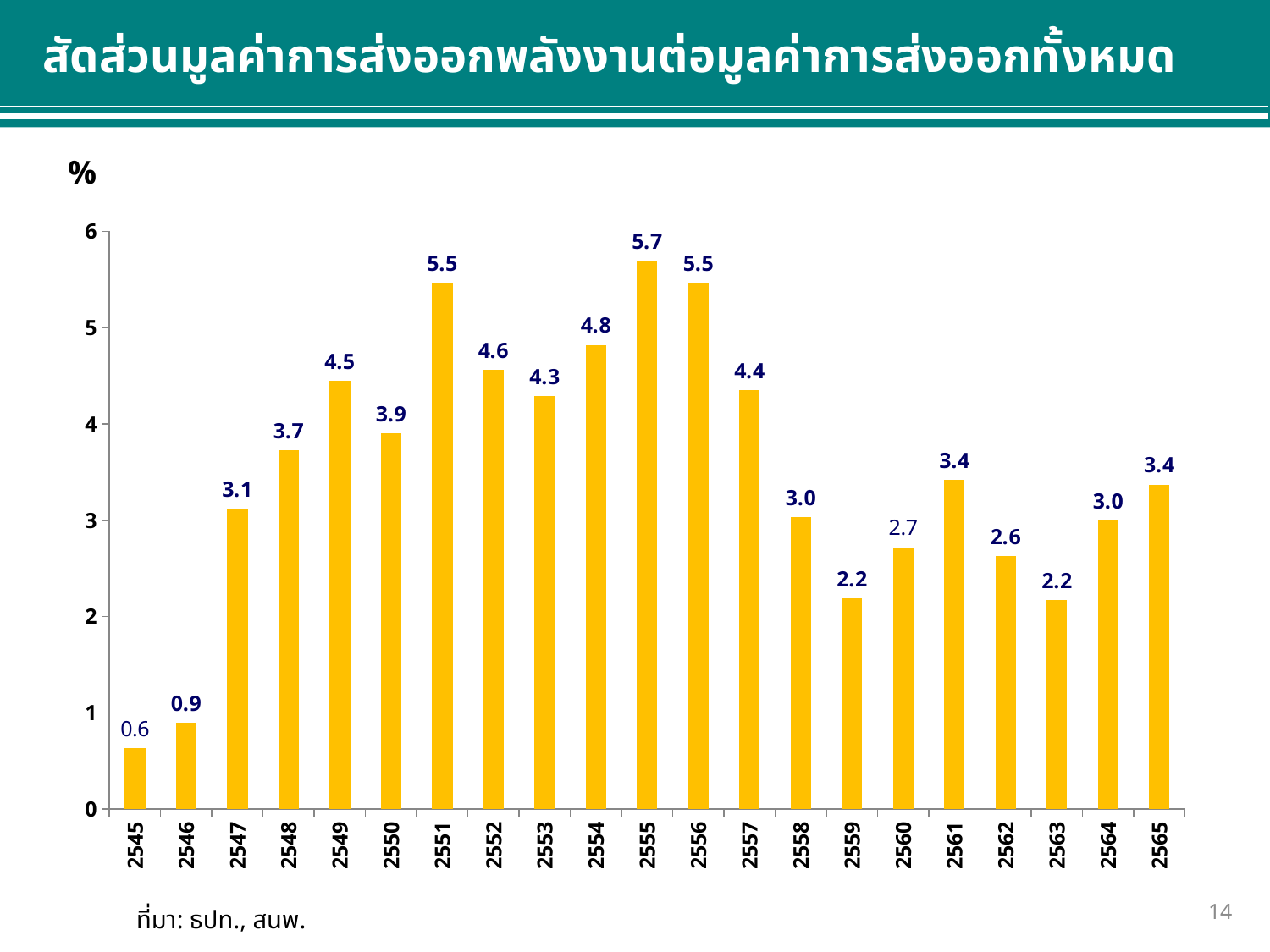
Which is larger, the value for 2549 or the value for 2553? 2549 What kind of chart is shown on the slide? bar chart How many years are shown on the x axis? 21 Do the values rise or fall from 2556 to 2559? fall What is the value for 2560? 2.7 What is the difference between the values for 2555 and 2545? 5.1 Which is larger, the value for 2558 or the value for 2561? 2561 Which year has the highest value? 2555 Which year has the lowest value? 2545 What is the value for 2545? 0.6 What is the value for 2555? 5.7 What is the difference between the values for 2551 and 2550? 1.6